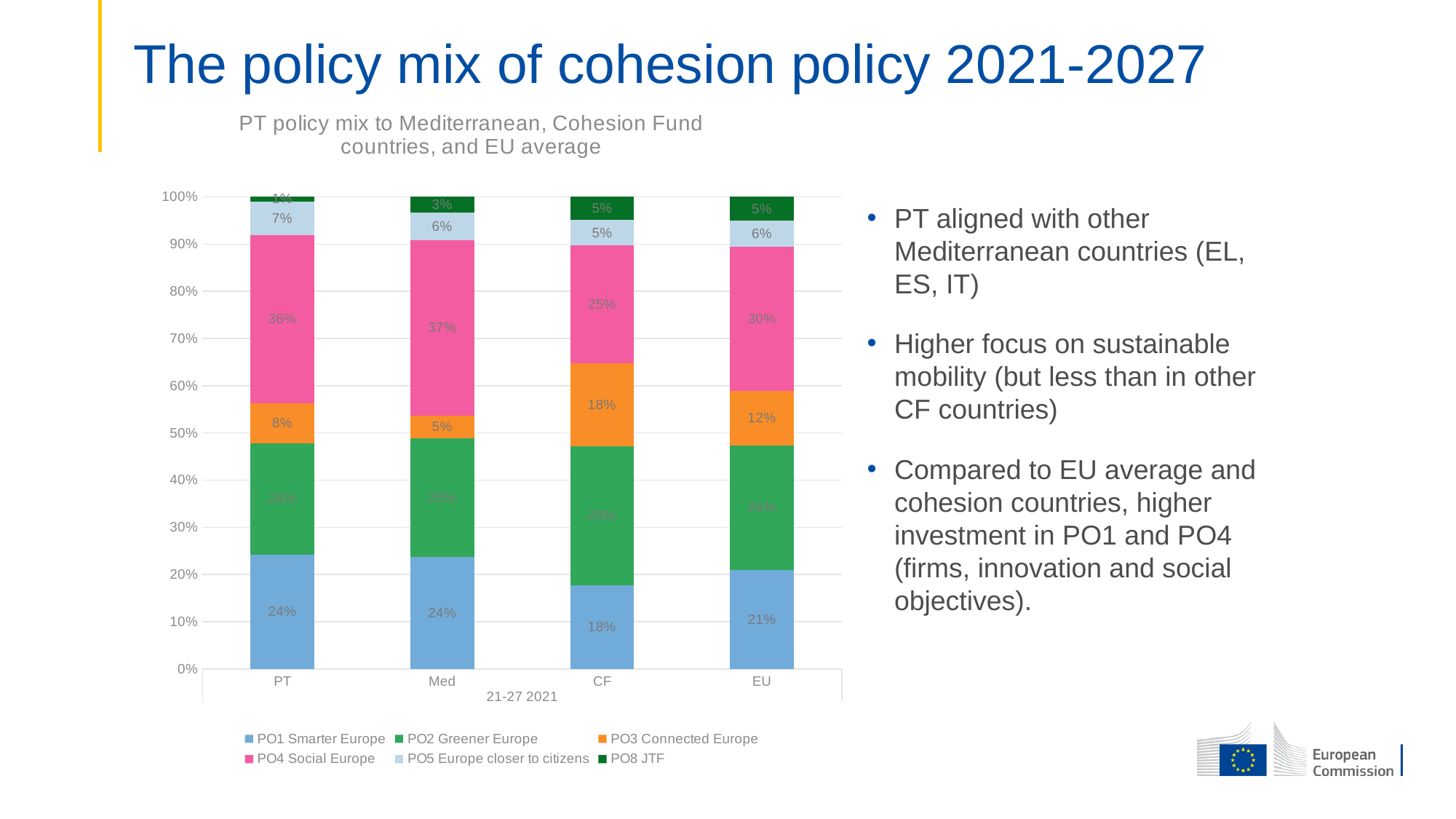
What kind of chart is shown on the slide? Stacked bar chart What is the value of PO1 Smarter Europe for EU? 21% What is the title of the chart? PT policy mix to Mediterranean, Cohesion Fund countries, and EU average How many series does the chart's legend list? 6 What is the difference between the PO4 Social Europe values for PT and CF? 11 percentage points Which category has the highest value for PO3 Connected Europe? CF What is the value of PO3 Connected Europe for CF? 18% Which has the larger PO3 Connected Europe value, PT or EU? EU What is the value of PO4 Social Europe for PT? 36% Which category has the lowest value for PO1 Smarter Europe? CF What is the value of PO8 JTF for Med? 3% How many categories are shown on the x axis of the chart? 4